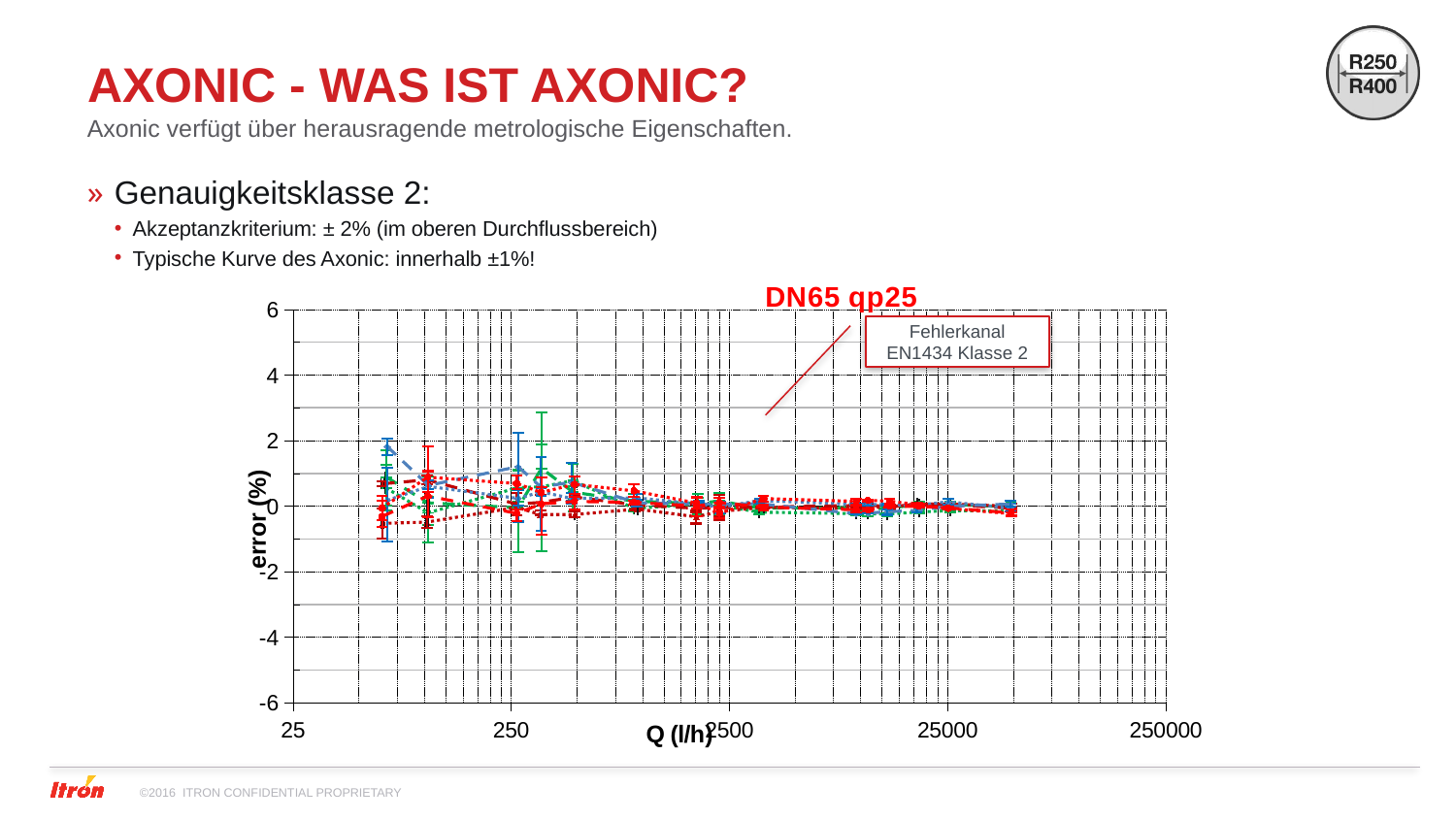
Does the spread of the plotted error values get larger or smaller as Q increases along the x axis? smaller What is the largest tick value shown on the x axis of the chart? 250000 What is the lowest value shown on the y axis of the chart? -6 What is the label of the x axis of the chart? Q (l/h) Are the plotted error values at Q = 25000 l/h greater or less than 2? less What kind of chart is shown on the slide? line chart Are the plotted error values at Q = 25000 l/h greater or less than -2? greater How many labelled tick values are shown on the x axis of the chart? 5